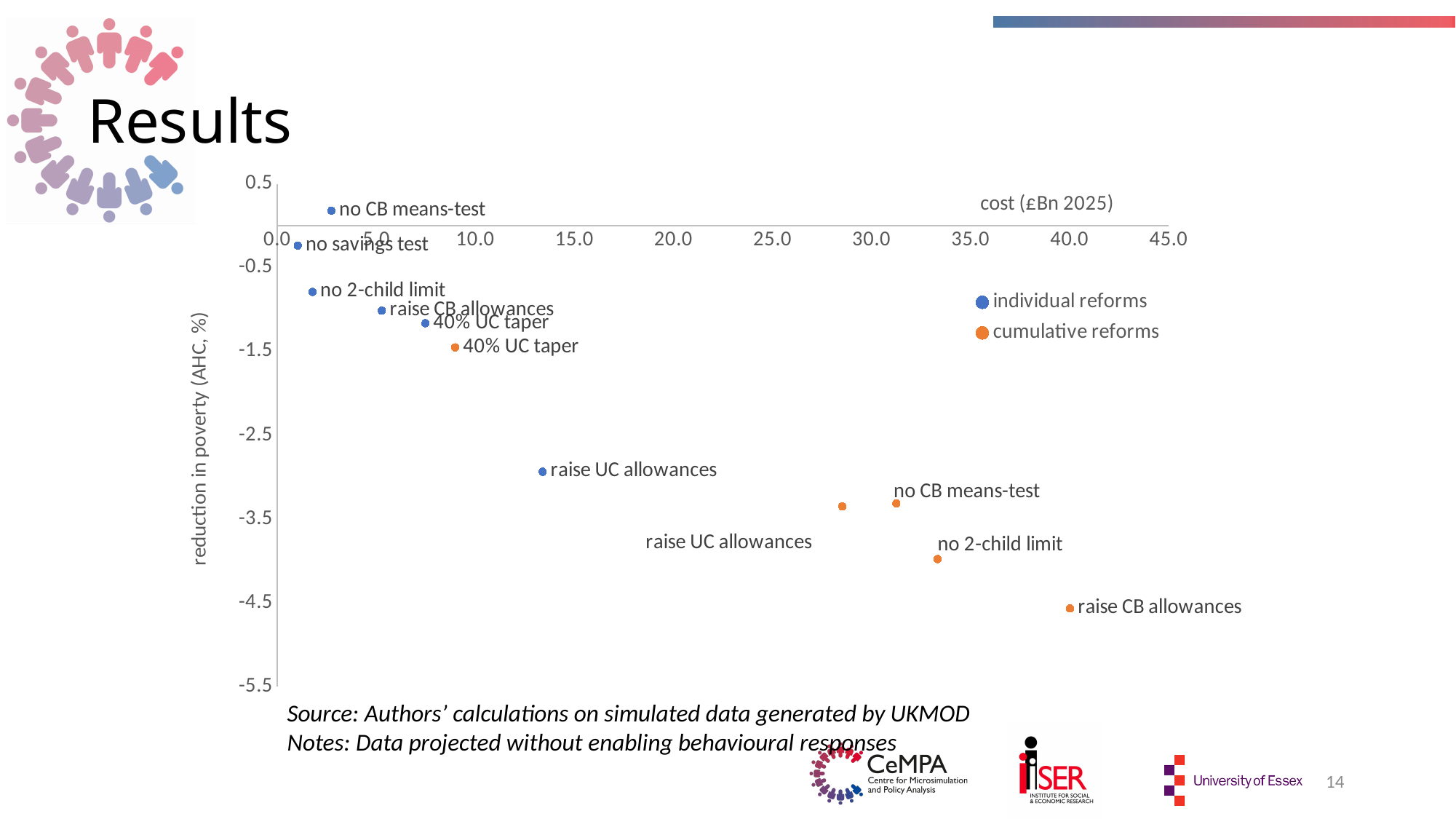
Is the cost of the individual reforms point 'raise UC allowances' greater or less than 10.0? greater How many series does the legend list? 2 What kind of chart is shown on the slide? scatter chart What is the label of the horizontal axis? cost (£Bn 2025) Is the cost of the cumulative reforms point 'raise CB allowances' greater or less than 35.0? greater Among the individual reforms points, which has the highest cost? raise UC allowances Is the reduction in poverty for the cumulative reforms point 'no 2-child limit' greater or less than -3.5? less How many points are plotted for the cumulative reforms series? 5 What are the two series named in the legend? individual reforms, cumulative reforms Which point has the largest reduction in poverty (lowest value on the vertical axis)? raise CB allowances (cumulative reforms) Which has the higher cost: the individual reforms point 'raise UC allowances' or the cumulative reforms point 'raise UC allowances'? cumulative reforms 'raise UC allowances' How many points are plotted for the individual reforms series? 6